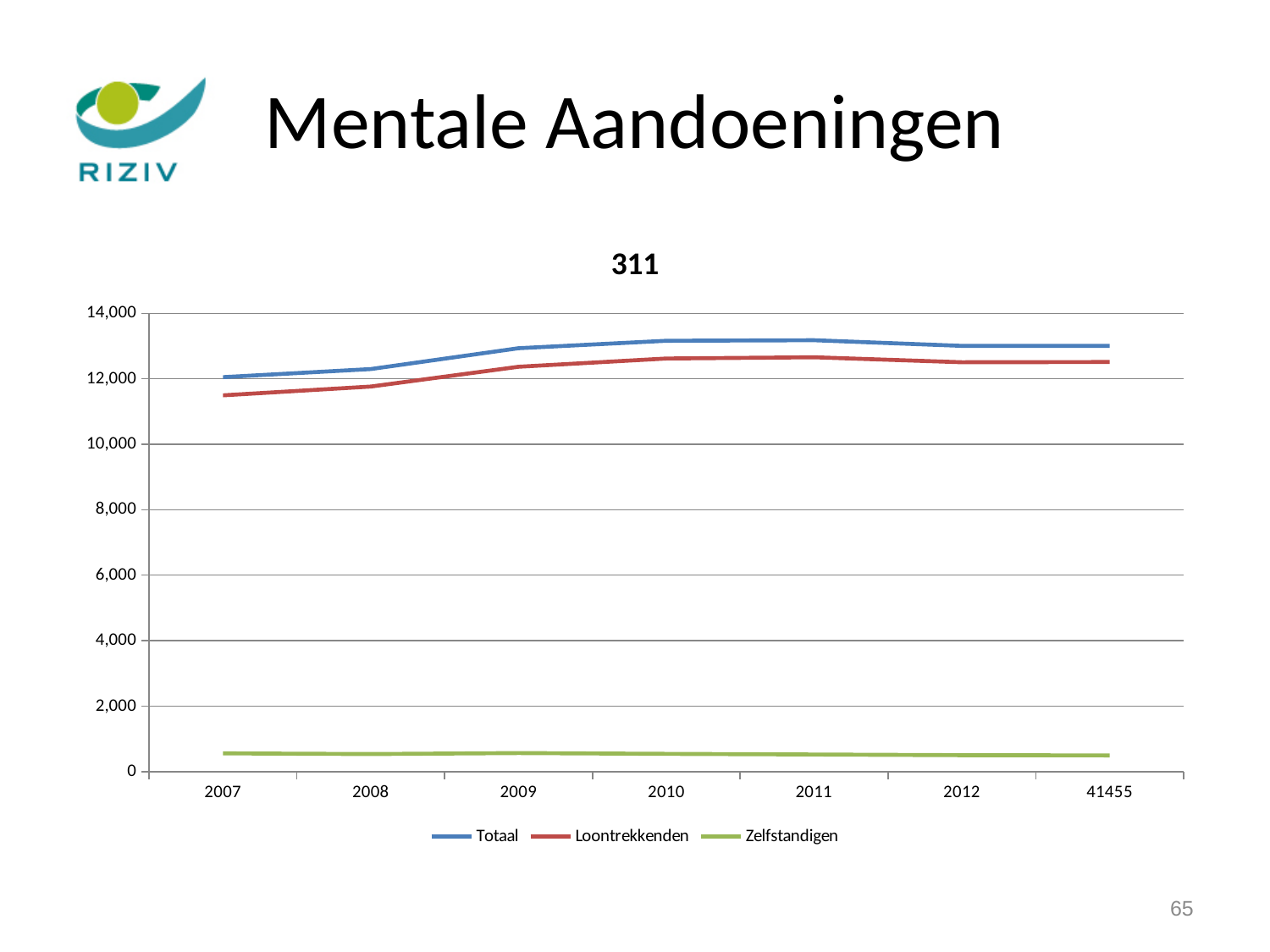
Which series has the lowest values across all years? Zelfstandigen Is the value for Totaal in 2011 greater or less than 12,000? greater What kind of chart is shown on the slide? line chart Which series is drawn in green in the legend? Zelfstandigen Which series has the highest values across all years? Totaal What is the title of the chart? 311 Is the value for Loontrekkenden in 2010 greater or less than 10,000? greater Is the value for Loontrekkenden in 2007 greater or less than 12,000? less How many points are plotted along the x axis for each series? 7 Does the Totaal series rise or fall from 2007 to 2011? rise How many series does the legend list? 3